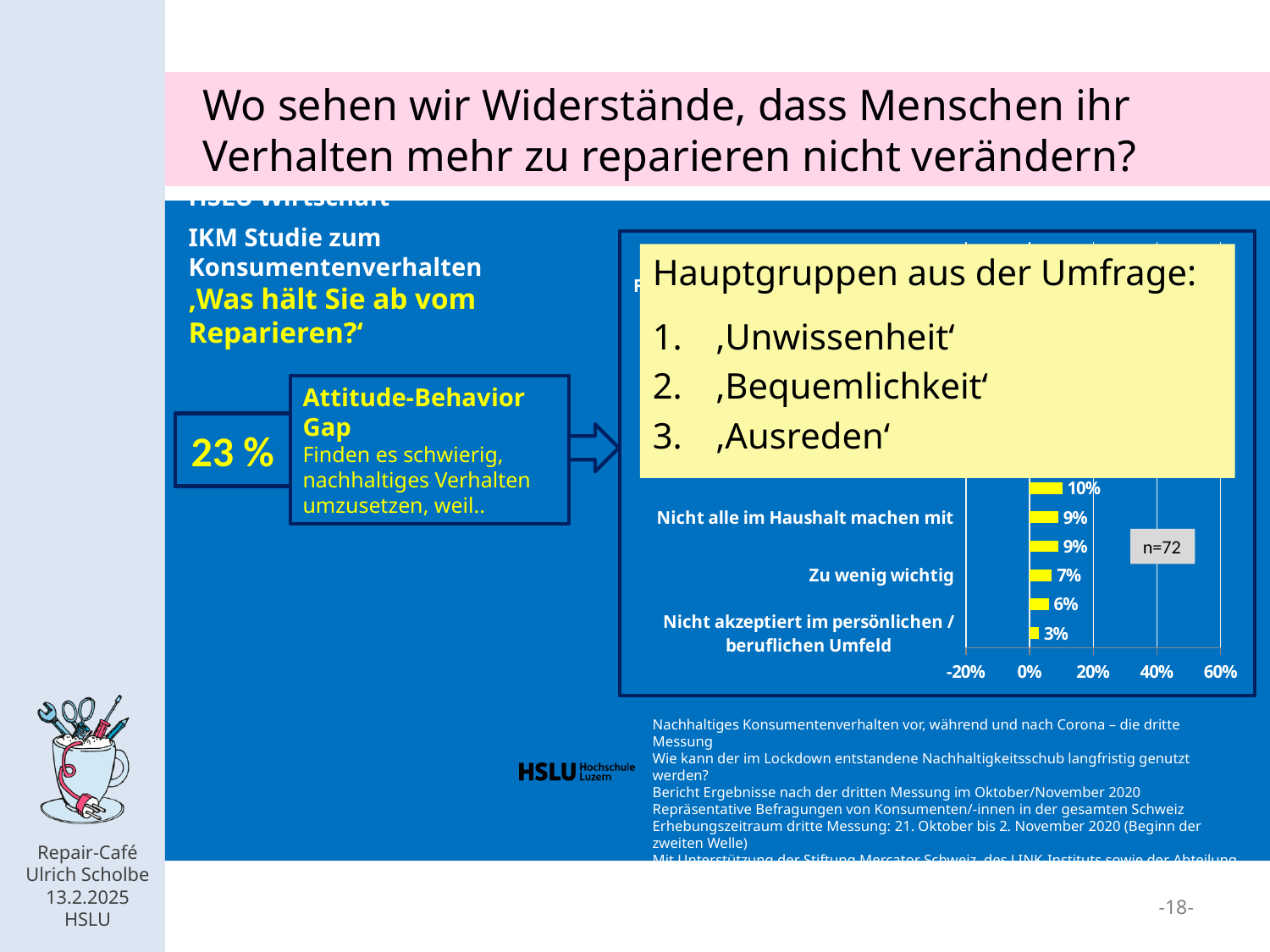
In the bar chart on the right, what is the difference between 'Nicht alle im Haushalt machen mit' and 'Nicht akzeptiert im persönlichen / beruflichen Umfeld'? 6% In the bar chart on the right, what is the difference between 'Zu wenig wichtig' and 'Nicht akzeptiert im persönlichen / beruflichen Umfeld'? 4% In the bar chart on the right, what is the value for 'Zu wenig wichtig'? 7% In the bar chart on the right, which is larger: 'Zu wenig wichtig' or 'Nicht akzeptiert im persönlichen / beruflichen Umfeld'? Zu wenig wichtig In the bar chart on the right, is the value for 'Nicht alle im Haushalt machen mit' greater or less than 20%? less In the bar chart on the right, what is the value for 'Nicht alle im Haushalt machen mit'? 9% What kind of chart is shown on the right of the slide? Bar chart What are the lowest and highest tick values on the horizontal axis of the bar chart on the right? -20% and 60% What sample size (n) is noted on the bar chart on the right? n=72 Of the three readable category labels in the bar chart on the right, which has the lowest value? Nicht akzeptiert im persönlichen / beruflichen Umfeld In the bar chart on the right, what is the value for 'Nicht akzeptiert im persönlichen / beruflichen Umfeld'? 3% In the bar chart on the right, which is larger: 'Nicht alle im Haushalt machen mit' or 'Zu wenig wichtig'? Nicht alle im Haushalt machen mit